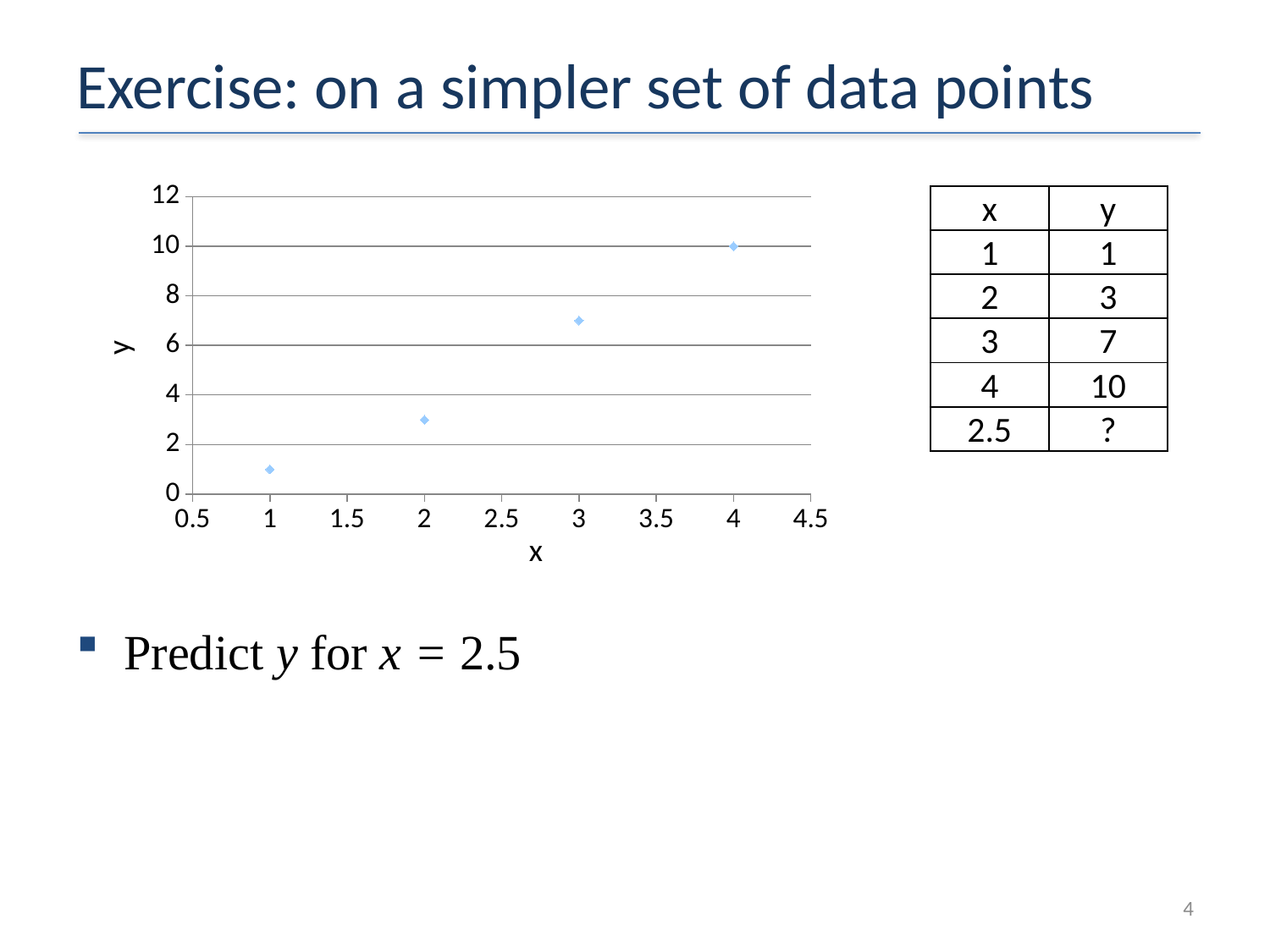
Is the y value of the point at x = 3 greater or less than 6? greater What kind of chart is shown on the slide? scatter chart Do the y values rise or fall as x increases along the x axis? rise What is the y value of the point at x = 4? 10 Which has the larger y value, the point at x = 2 or the point at x = 3? x = 3 What is the y value of the point at x = 3? 7 How many data points are plotted on the chart? 4 At which x value is the plotted y value highest? 4 What is the y value of the point at x = 2? 3 What is the title of the vertical axis of the chart? y What is the difference between the y values at x = 4 and x = 1? 9 At which x value is the plotted y value lowest? 1